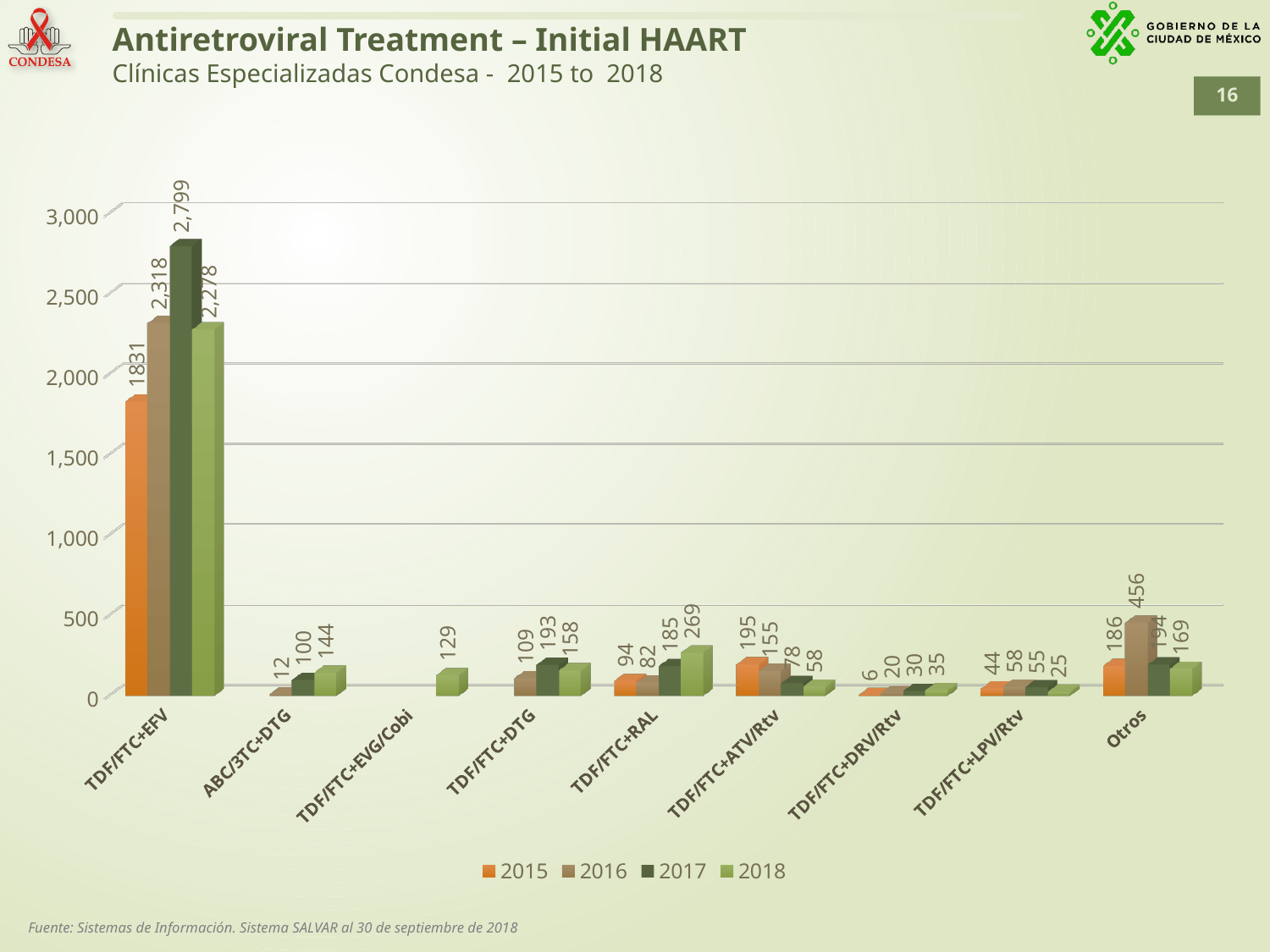
What is the value for Otros in 2016? 456 What is the value for TDF/FTC+RAL in 2018? 269 What is the difference between the 2017 and 2016 values for TDF/FTC+EFV? 481 Which is larger, the 2015 value for TDF/FTC+ATV/Rtv or the 2015 value for Otros? 2015 value for TDF/FTC+ATV/Rtv Do the values for TDF/FTC+ATV/Rtv rise or fall from 2015 to 2018? Fall What is the value for TDF/FTC+EVG/Cobi in 2018? 129 Which year has the highest value for TDF/FTC+EFV? 2017 What is the value for TDF/FTC+EFV in 2017? 2,799 Which year has the lowest value for TDF/FTC+DRV/Rtv? 2015 What kind of chart is shown on the slide? Bar chart How many treatment categories are shown on the x axis? 9 How many series does the legend list? 4